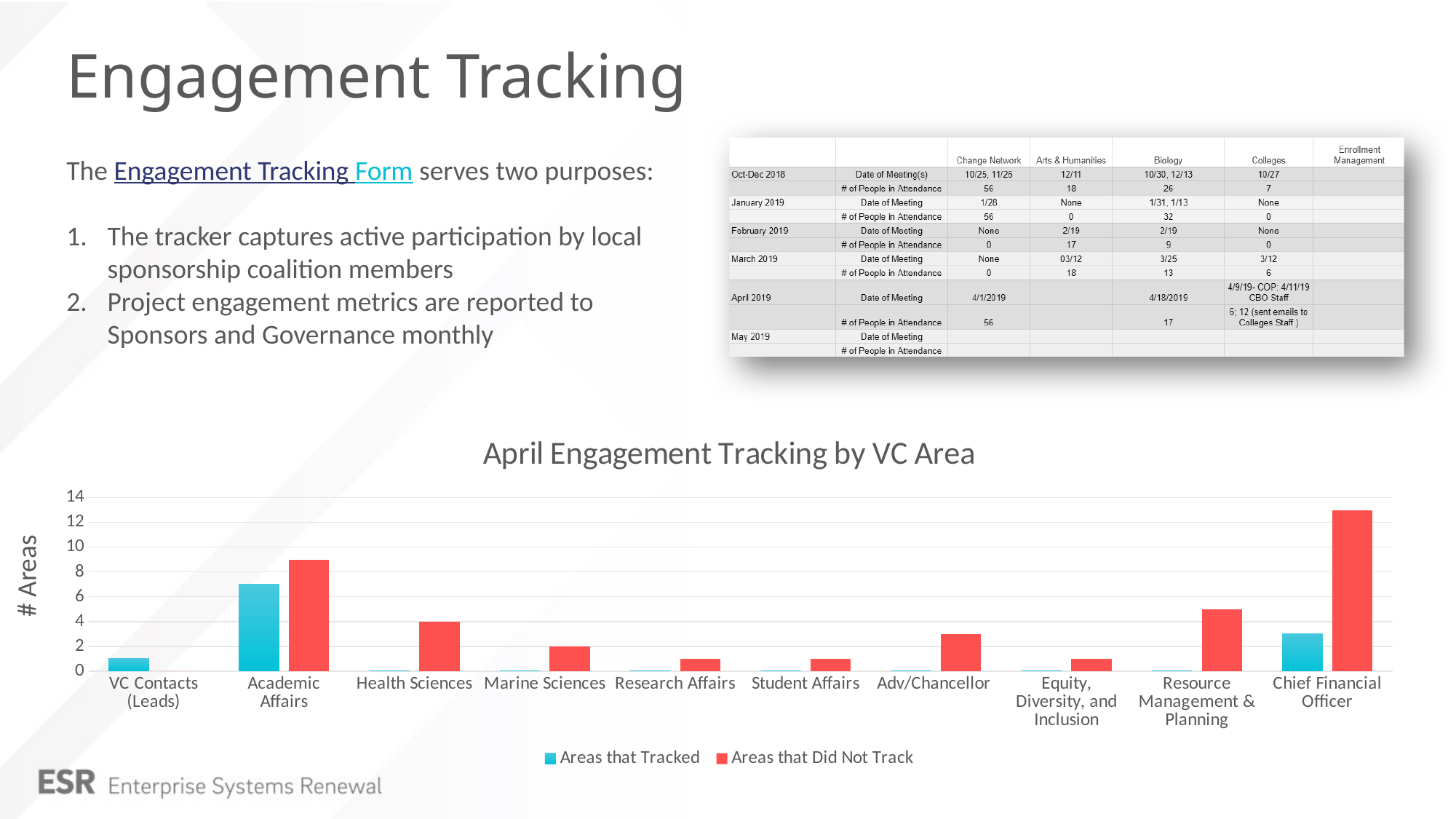
Which VC area has the highest value for Areas that Did Not Track? Chief Financial Officer How many VC area categories are shown on the x axis of the chart? 10 What kind of chart is shown on the slide? bar chart What is the label on the y axis of the chart? # Areas Is the value of Areas that Tracked for Academic Affairs greater or less than 6? greater What is the value of Areas that Did Not Track for Marine Sciences? 2 Which VC area has the highest value for Areas that Tracked? Academic Affairs Is the value of Areas that Did Not Track for Chief Financial Officer greater or less than 12? greater For Academic Affairs, which is larger: Areas that Tracked or Areas that Did Not Track? Areas that Did Not Track What is the title of the chart on the slide? April Engagement Tracking by VC Area How many series does the chart's legend list? 2 What is the value of Areas that Did Not Track for Health Sciences? 4